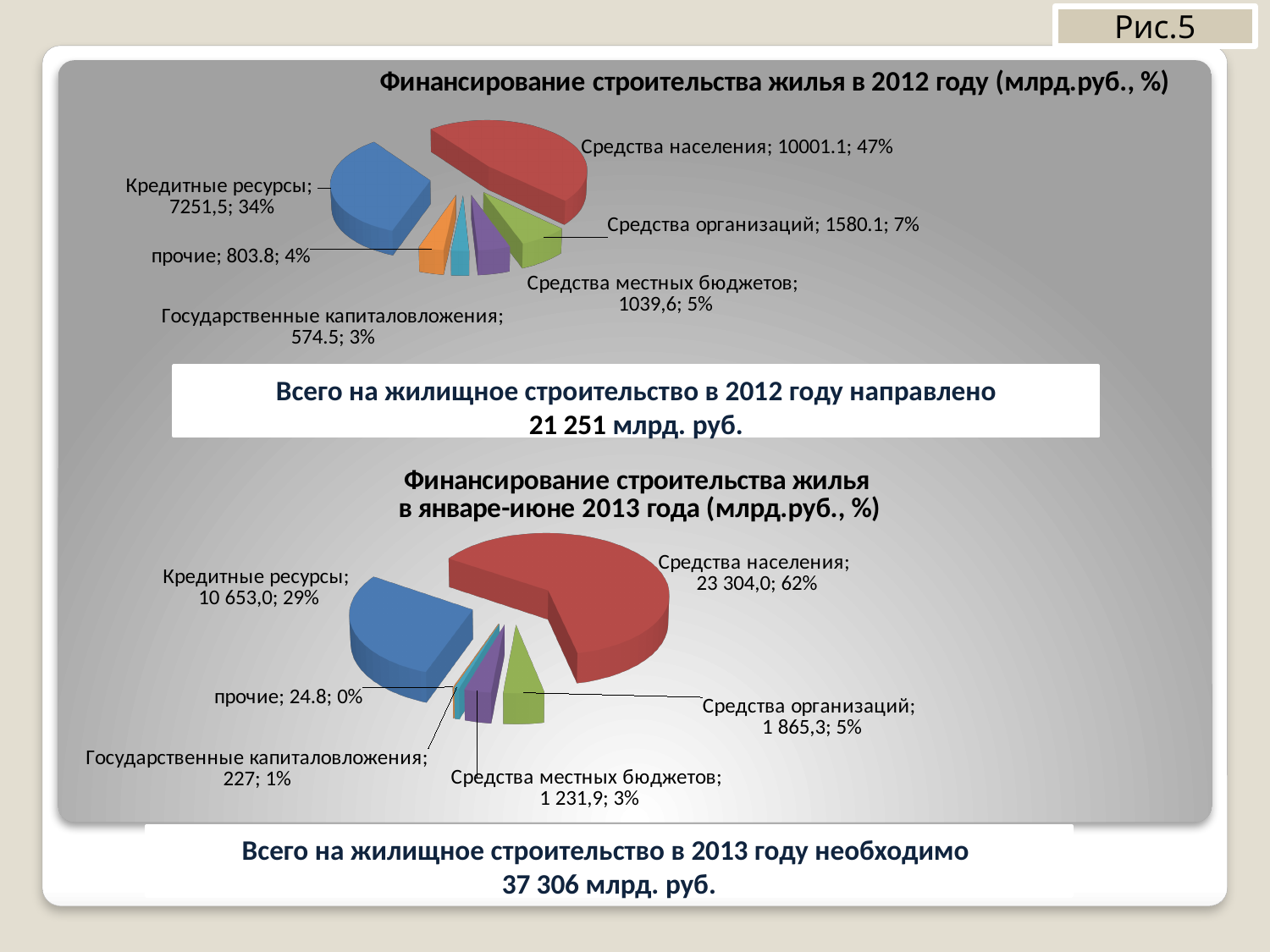
In the top chart (2012), how many categories are shown? 6 In the bottom chart (январь-июнь 2013), which category has the smallest value? прочие In the bottom chart (январь-июнь 2013), what is the value for Кредитные ресурсы? 10 653,0 In the top chart (2012), which category has the largest value? Средства населения In the top chart (2012), what share of the pie is Кредитные ресурсы? 34% In the bottom chart (январь-июнь 2013), which is larger: Средства организаций or Государственные капиталовложения? Средства организаций In the top chart (2012), what is the value for Средства населения? 10001.1 In the top chart (2012), which category has the smallest value? Государственные капиталовложения In the bottom chart (январь-июнь 2013), what is the value for Средства местных бюджетов? 1 231,9 In the top chart (2012), which is larger: Средства организаций or прочие? Средства организаций In the bottom chart (январь-июнь 2013), what share of the pie is Средства населения? 62% What type of chart is used in the top chart 'Финансирование строительства жилья в 2012 году'? pie chart